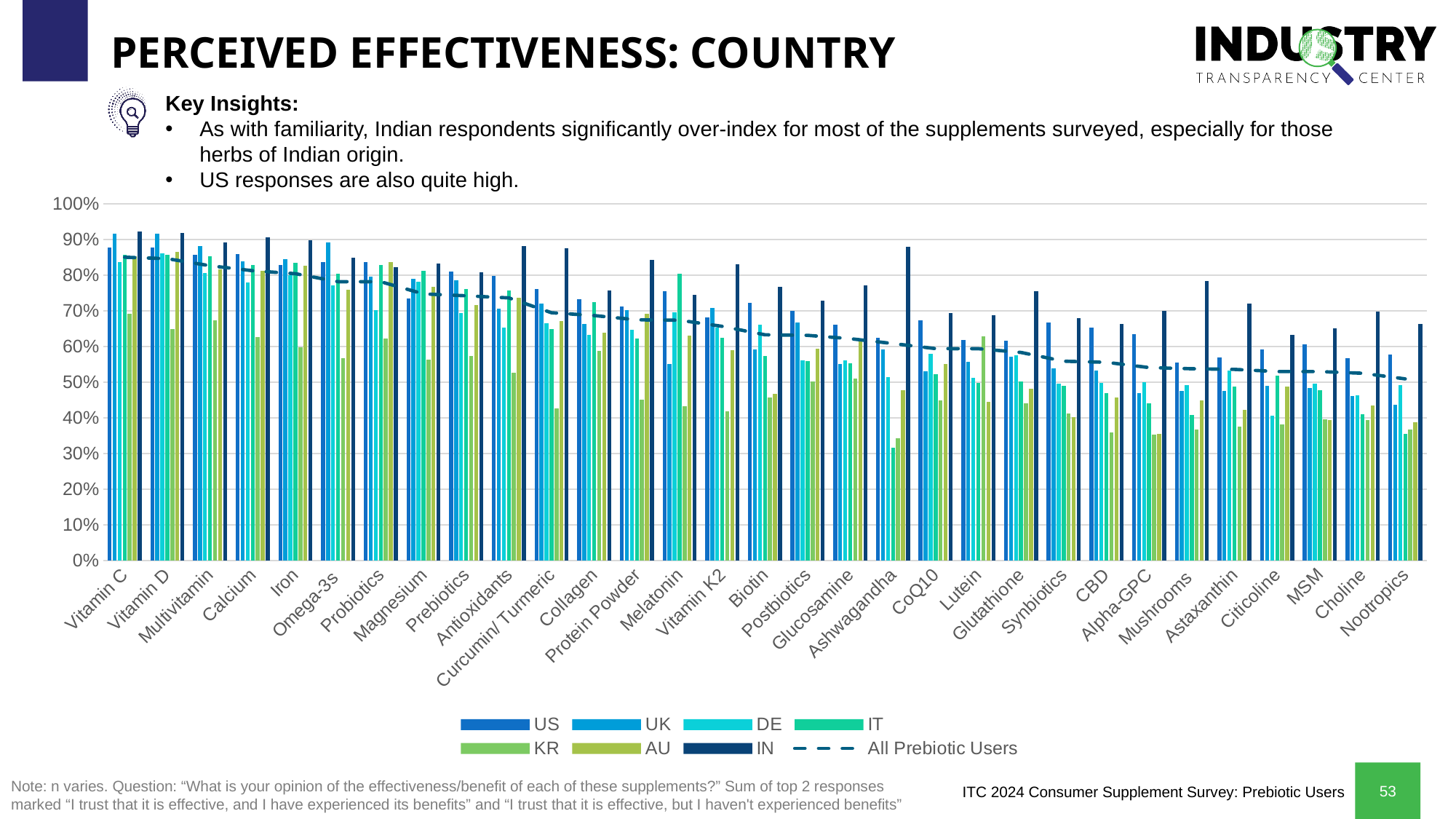
What kind of chart is shown on the slide? combination bar and line chart Is the value for DE for Ashwagandha greater or less than 40%? greater How many supplement categories are shown along the x axis? 31 For Ashwagandha, which is larger: the IN value or the DE value? IN Which series is shown as a dashed line rather than bars? All Prebiotic Users Is the value for AU for Vitamin C greater or less than 80%? greater Is the value for IN for Ashwagandha greater or less than 80%? greater Does the dashed 'All Prebiotic Users' line rise or fall from left to right across the chart? fall How many entries does the legend list? 8 Which is larger: the US value for Vitamin C or the US value for Nootropics? Vitamin C